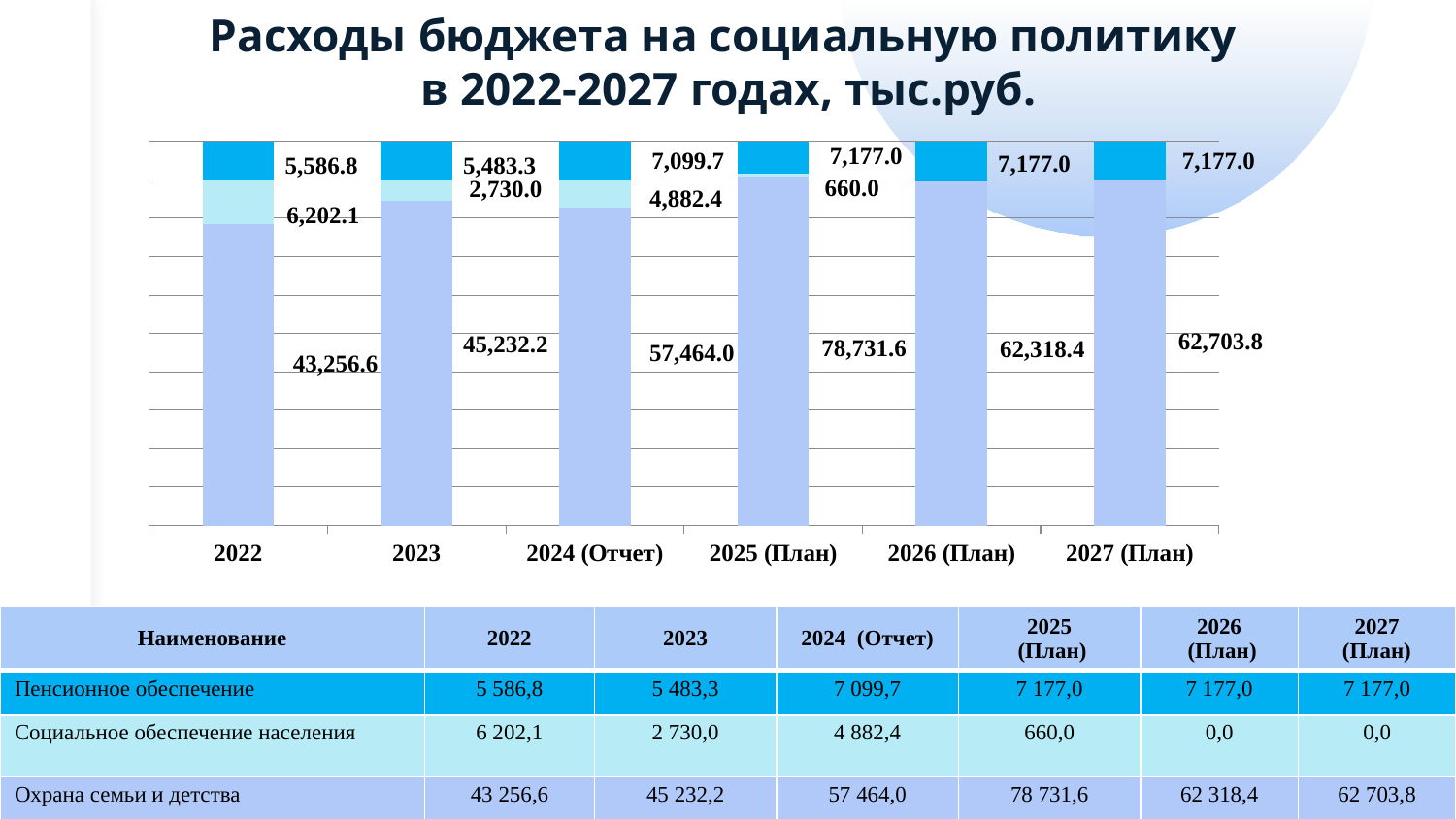
How many years (categories) are shown on the x axis of the chart? 6 What is the value of the top (dark blue) segment of the bar for 2024 (Отчет)? 7,099.7 What is the value of the middle (light cyan) segment of the bar for 2022? 6,202.1 In which year is the bottom segment (Охрана семьи и детства) the lowest? 2022 What is the value of the largest (bottom) segment of the bar for 2025 (План)? 78,731.6 What is the total of the stacked bar for 2025 (План)? 86,568.6 What kind of chart is shown on the slide? Stacked bar chart What is the total of the stacked bar for 2022? 55,045.5 In which year is the bottom segment (Охрана семьи и детства) the highest? 2025 (План) Does the top segment (Пенсионное обеспечение) rise or fall from 2023 to 2025 (План)? Rise Which is larger: the bottom segment value for 2026 (План) or for 2027 (План)? 2027 (План) What is the difference between the bottom segment values for 2025 (План) and 2024 (Отчет)? 21,267.6